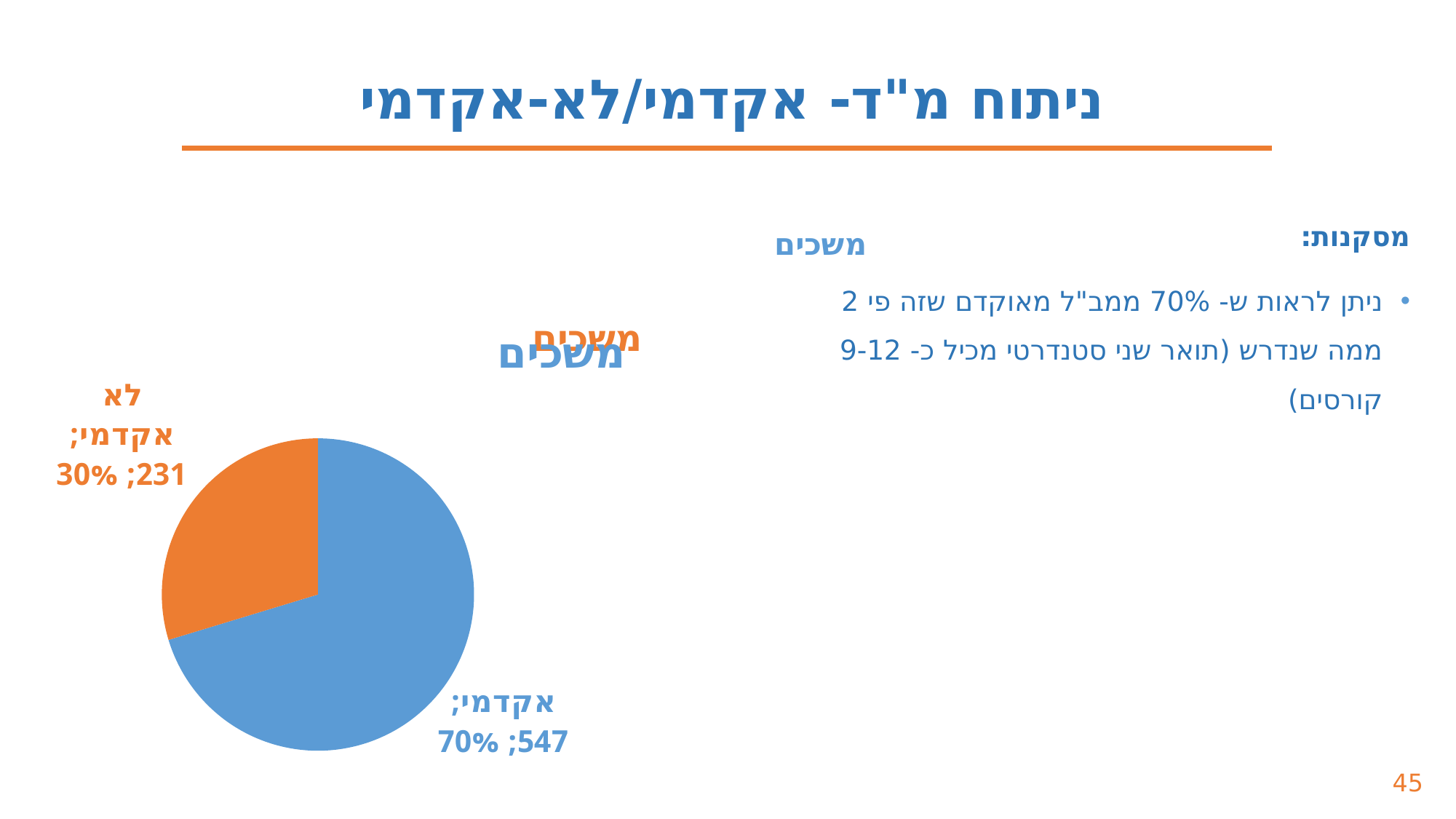
Which is larger, the אקדמי slice or the לא אקדמי slice? אקדמי What colour is the אקדמי slice in the pie chart? blue Which slice is the smallest in the pie chart? לא אקדמי What share of the pie does the לא אקדמי slice represent? 30% What is the value for the אקדמי slice? 547 What is the difference between the אקדמי value and the לא אקדמי value? 316 Which slice is the largest in the pie chart? אקדמי What is the value for the לא אקדמי slice? 231 How many slices does the pie chart have? 2 What share of the pie does the אקדמי slice represent? 70% What is the total of the two slice values in the pie chart? 778 What kind of chart is shown on the slide? pie chart